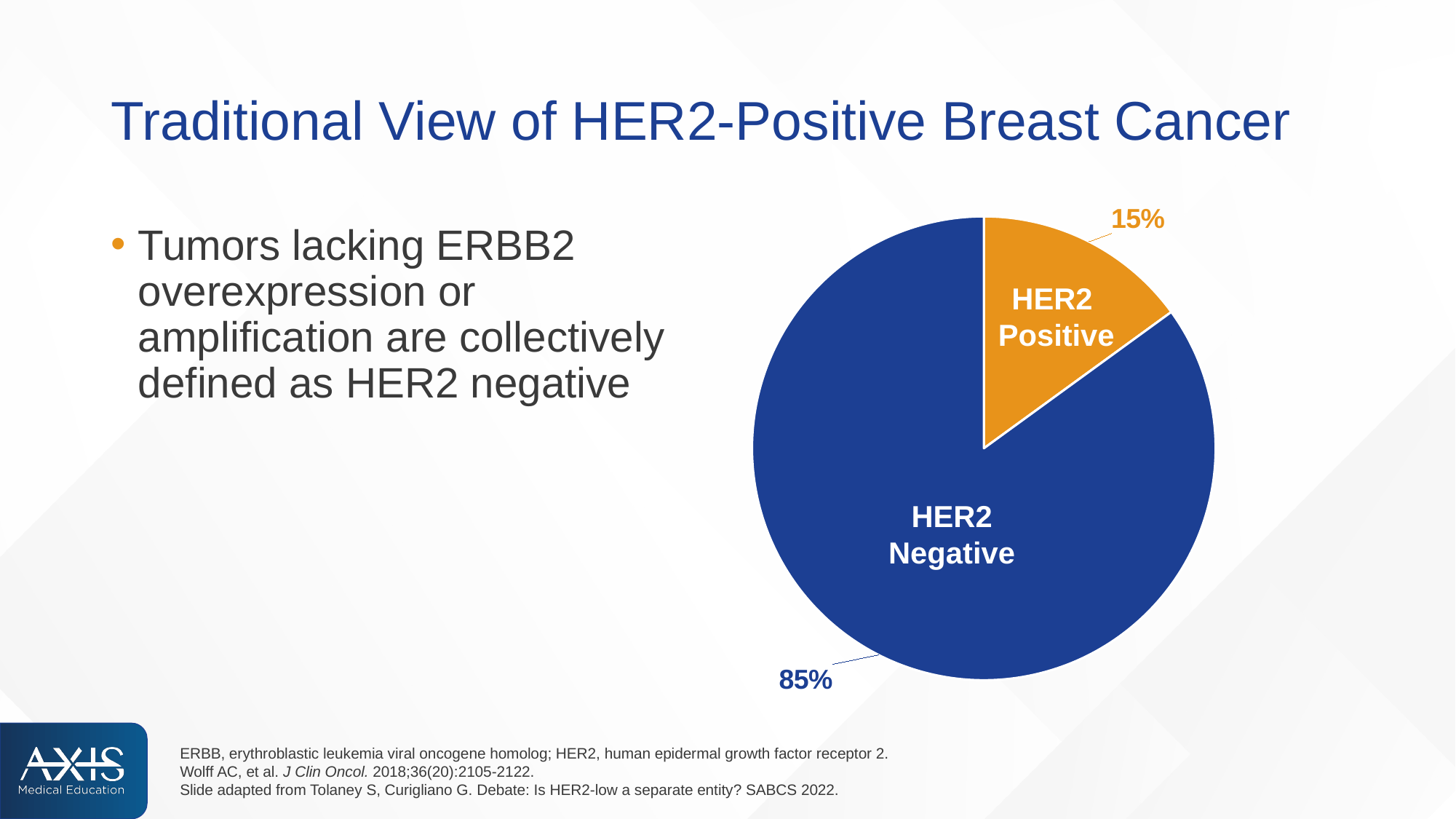
Which slice of the pie is the largest? HER2 Negative What share of the pie does the HER2 Positive slice represent? 15% What percentage of the pie is HER2 Negative? 85% What percentage of the pie is HER2 Positive? 15% What colour is the HER2 Negative slice? blue What kind of chart is shown on the slide? pie chart How many slices does the pie chart have? 2 Which is larger, the HER2 Positive slice or the HER2 Negative slice? HER2 Negative What colour is the HER2 Positive slice? orange Which slice of the pie is the smallest? HER2 Positive What is the difference in percentage points between the HER2 Negative and HER2 Positive slices? 70